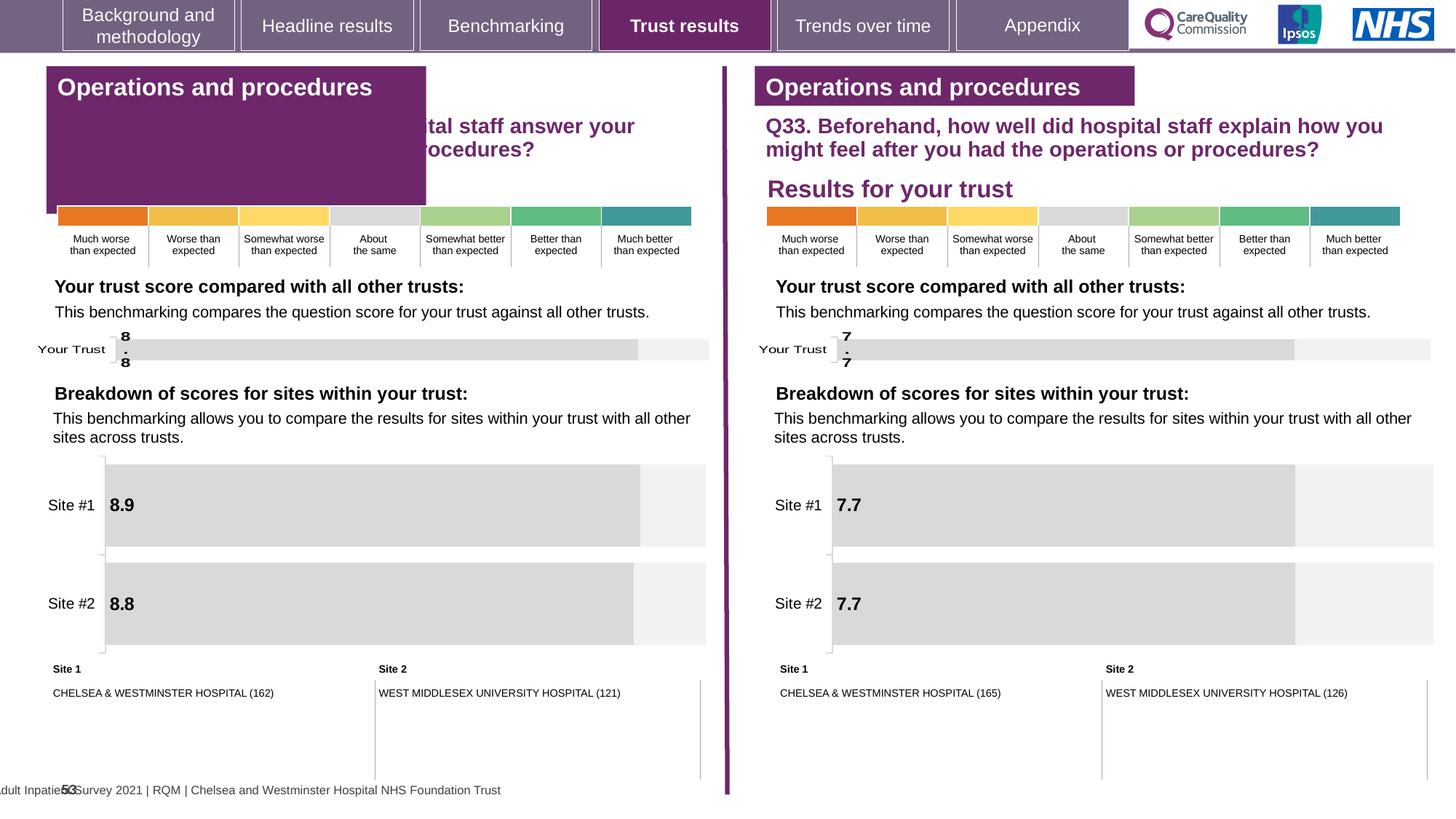
On the left panel's site breakdown chart, which site has the higher score? Site #1 On the right panel (Q33) 'Your Trust' chart, what is the trust score shown? 7.7 On the left panel's site breakdown chart, what is the score for Site #2? 8.8 On the right panel (Q33) site breakdown chart, what is the score for Site #2? 7.7 What type of chart is used for the site breakdown on the right panel (Q33)? Bar chart Which hospital is listed as Site 1 on the right panel (Q33)? CHELSEA & WESTMINSTER HOSPITAL (165) How many sites are shown in the left panel's site breakdown chart? 2 On the left panel's 'Your Trust' chart, what is the trust score shown? 8.8 On the left panel's site breakdown chart, what is the difference between the Site #1 and Site #2 scores? 0.1 On the right panel (Q33) site breakdown chart, what is the score for Site #1? 7.7 On the left panel's site breakdown chart, what is the score for Site #1? 8.9 On the right panel (Q33) site breakdown chart, what is the difference between the Site #1 and Site #2 scores? 0